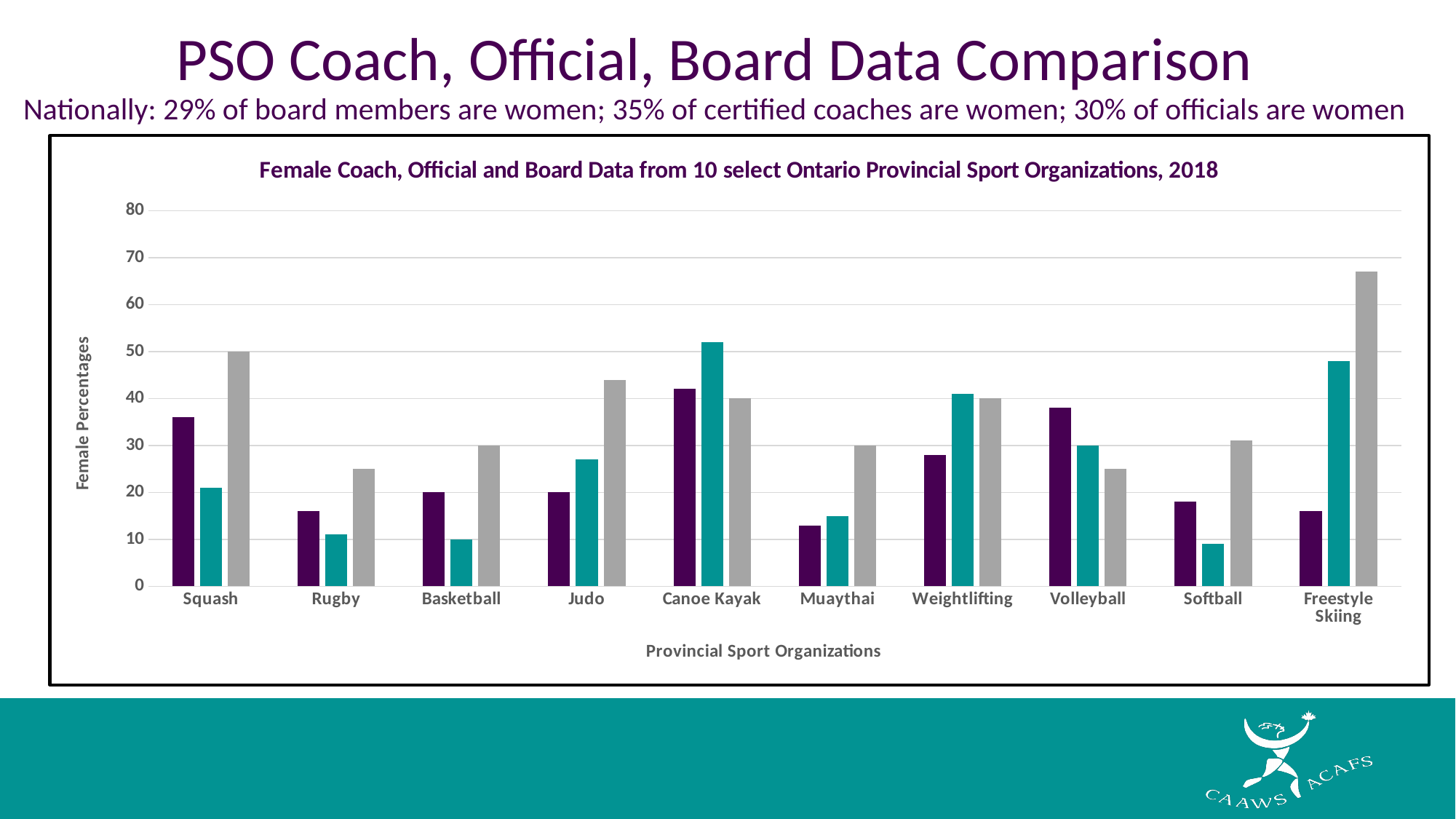
What kind of chart is shown on the slide? bar chart Is the purple bar for Volleyball greater or less than 30? greater What is the label on the vertical axis of the chart? Female Percentages What is the value of the teal bar for Volleyball? 30 How many provincial sport organizations are shown on the x axis of the chart? 10 What is the value of the grey bar for Squash? 50 What is the title of the chart? Female Coach, Official and Board Data from 10 select Ontario Provincial Sport Organizations, 2018 Is the teal bar for Rugby greater or less than 20? less What is the value of the grey bar for Canoe Kayak? 40 Is the purple bar for Squash greater or less than 30? greater Which organization has the tallest bar in the chart? Freestyle Skiing For Canoe Kayak, which is larger, the teal bar or the grey bar? teal bar